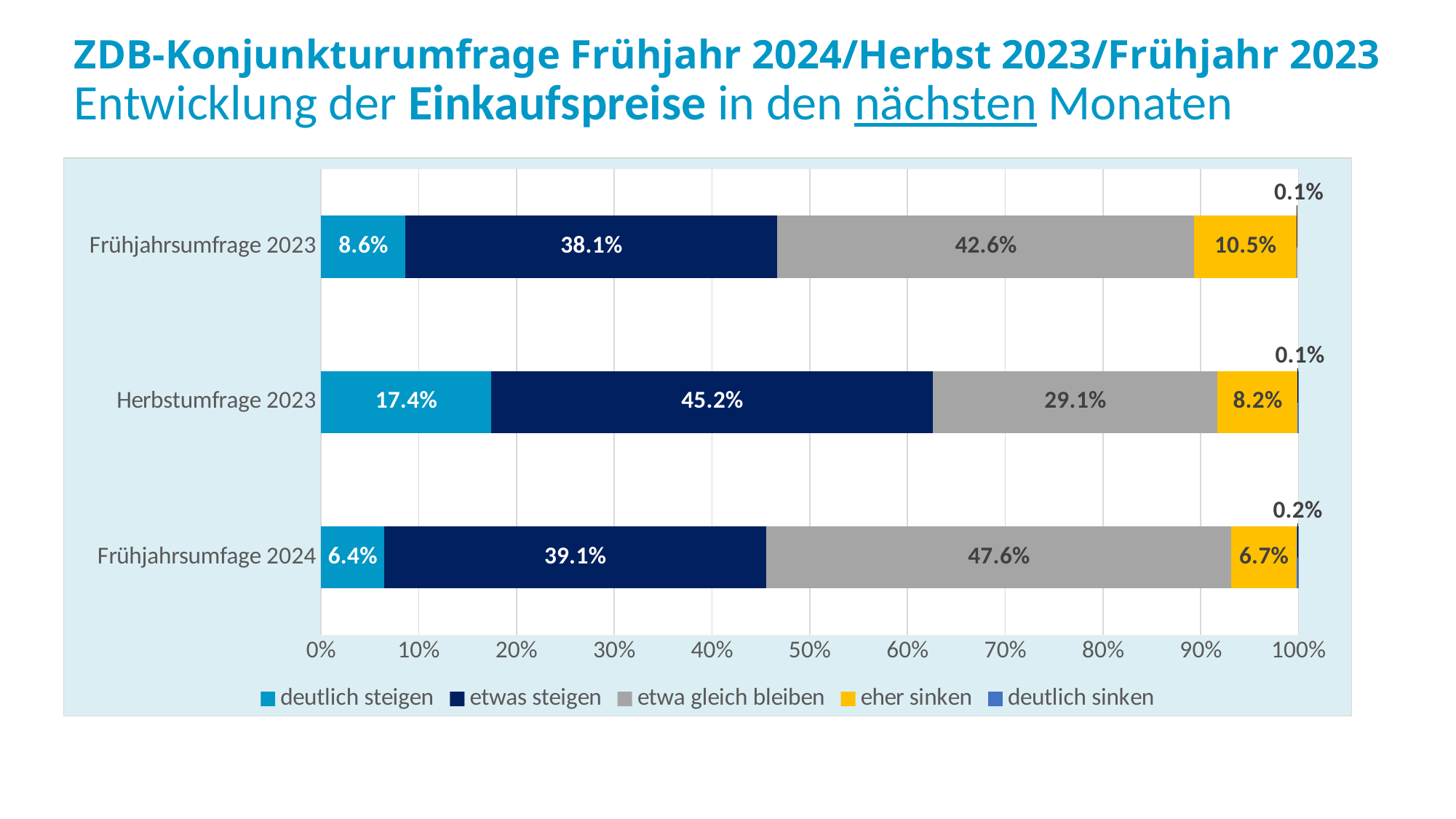
How many survey categories are shown on the chart? 3 What kind of chart is shown on the slide? Stacked bar chart What is the value for "etwas steigen" in the Herbstumfrage 2023? 45.2% Which is larger: "etwa gleich bleiben" in Frühjahrsumfrage 2023 or in Herbstumfrage 2023? Frühjahrsumfrage 2023 Which survey has the lowest value for "eher sinken"? Frühjahrsumfage 2024 What is the value for "deutlich steigen" in the Frühjahrsumfrage 2023? 8.6% What is the value for "deutlich sinken" in the Frühjahrsumfage 2024? 0.2% What is the value for "etwa gleich bleiben" in the Frühjahrsumfage 2024? 47.6% How many series does the legend list? 5 Which survey has the highest value for "deutlich steigen"? Herbstumfrage 2023 Which colour represents "eher sinken" in the legend? Yellow What is the difference between the "etwas steigen" values for Herbstumfrage 2023 and Frühjahrsumfage 2024? 6.1%